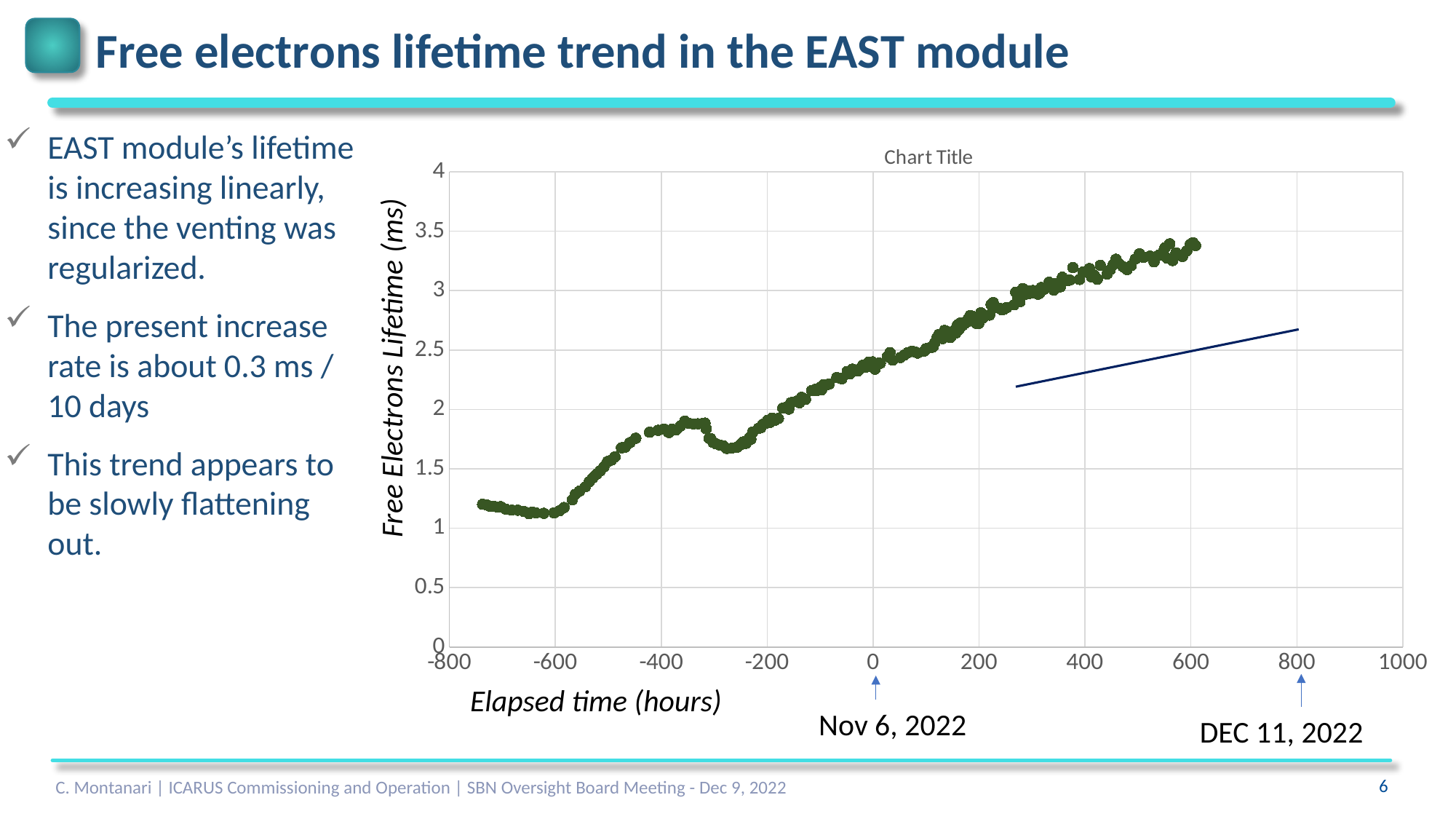
What is the label of the vertical axis of the chart? Free Electrons Lifetime (ms) Which is larger, the free electrons lifetime at 200 hours or at -200 hours? 200 hours What is the title printed above the chart? Chart Title Is the free electrons lifetime at an elapsed time of 400 hours greater or less than 2.5? greater Is the free electrons lifetime at an elapsed time of 600 hours greater or less than 3? greater Is the free electrons lifetime at an elapsed time of -600 hours greater or less than 1.5? less What kind of chart is shown on the slide? scatter chart Do the plotted values generally rise or fall as elapsed time increases from -600 to 600 hours? rise